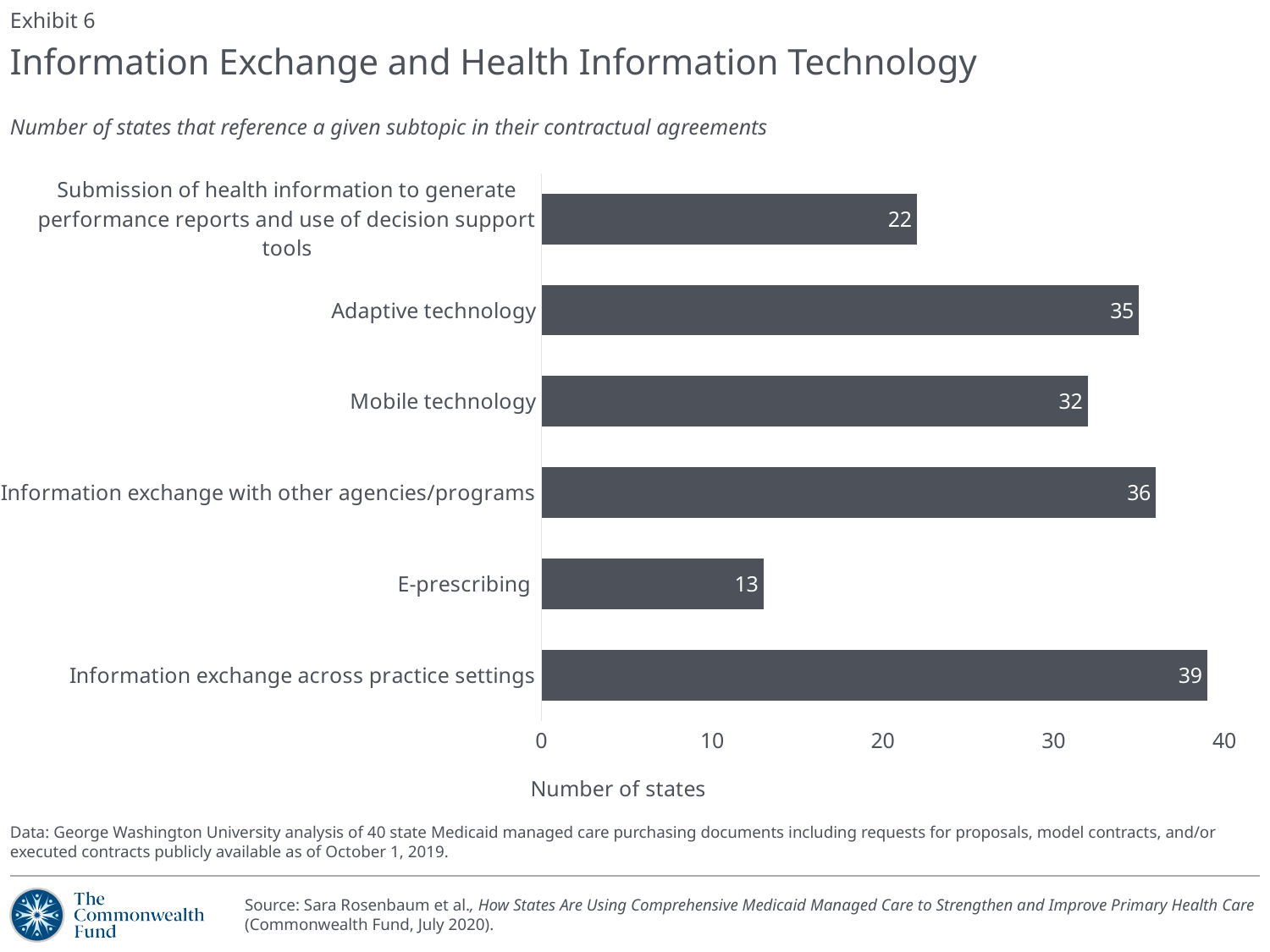
What is the difference in number of states between adaptive technology and mobile technology? 3 What is the value for submission of health information to generate performance reports and use of decision support tools? 22 What is the label of the x axis? Number of states How many states reference mobile technology? 32 What type of chart is shown on the slide? Bar chart What is the difference in number of states between information exchange across practice settings and E-prescribing? 26 Which subtopic is referenced by the fewest states? E-prescribing How many subtopics are shown in the chart? 6 What is the number of states for E-prescribing? 13 How many states reference adaptive technology in their contractual agreements? 35 Which subtopic is referenced by the most states? Information exchange across practice settings Which has more states referencing it: information exchange with other agencies/programs or mobile technology? Information exchange with other agencies/programs